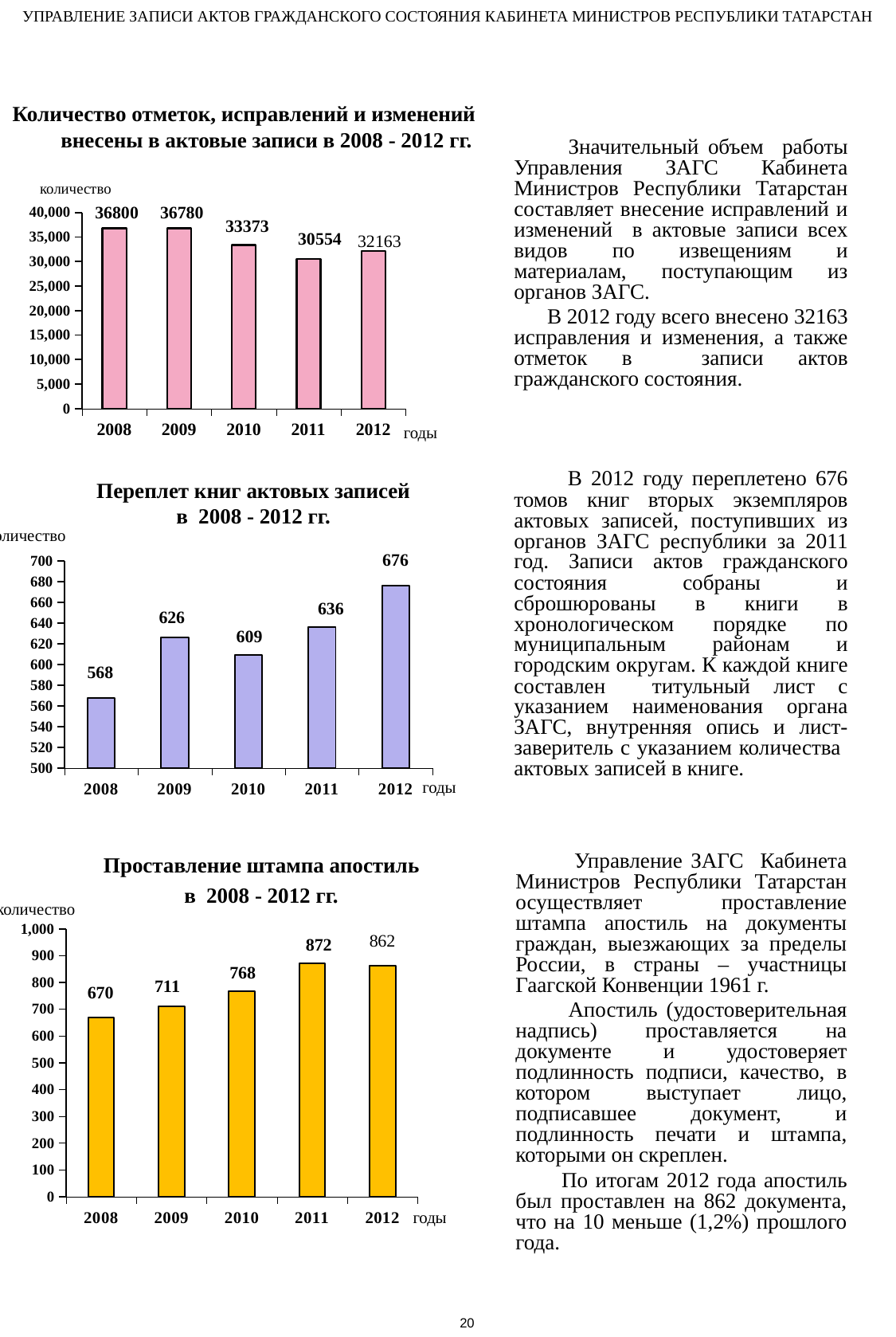
In the top chart (Количество отметок, исправлений и изменений), what is the difference between the 2008 and 2012 values? 4637 In the top chart (Количество отметок, исправлений и изменений), what is the value for 2010? 33373 In the bottom chart (Проставление штампа апостиль), what is the value for 2009? 711 In the bottom chart (Проставление штампа апостиль), what is the difference between the 2011 and 2012 values? 10 In the middle chart (Переплет книг актовых записей), what is the difference between the 2012 and 2008 values? 108 In the middle chart (Переплет книг актовых записей), which year has the highest value? 2012 In the top chart (Количество отметок, исправлений и изменений), which year has the lowest value? 2011 What kind of chart is the bottom chart (Проставление штампа апостиль)? Bar chart In the top chart (Количество отметок, исправлений и изменений), how many years are shown on the x axis? 5 In the middle chart (Переплет книг актовых записей), which is larger, the value for 2009 or for 2010? 2009 In the bottom chart (Проставление штампа апостиль), which year has the lowest value? 2008 In the middle chart (Переплет книг актовых записей), what is the value for 2011? 636